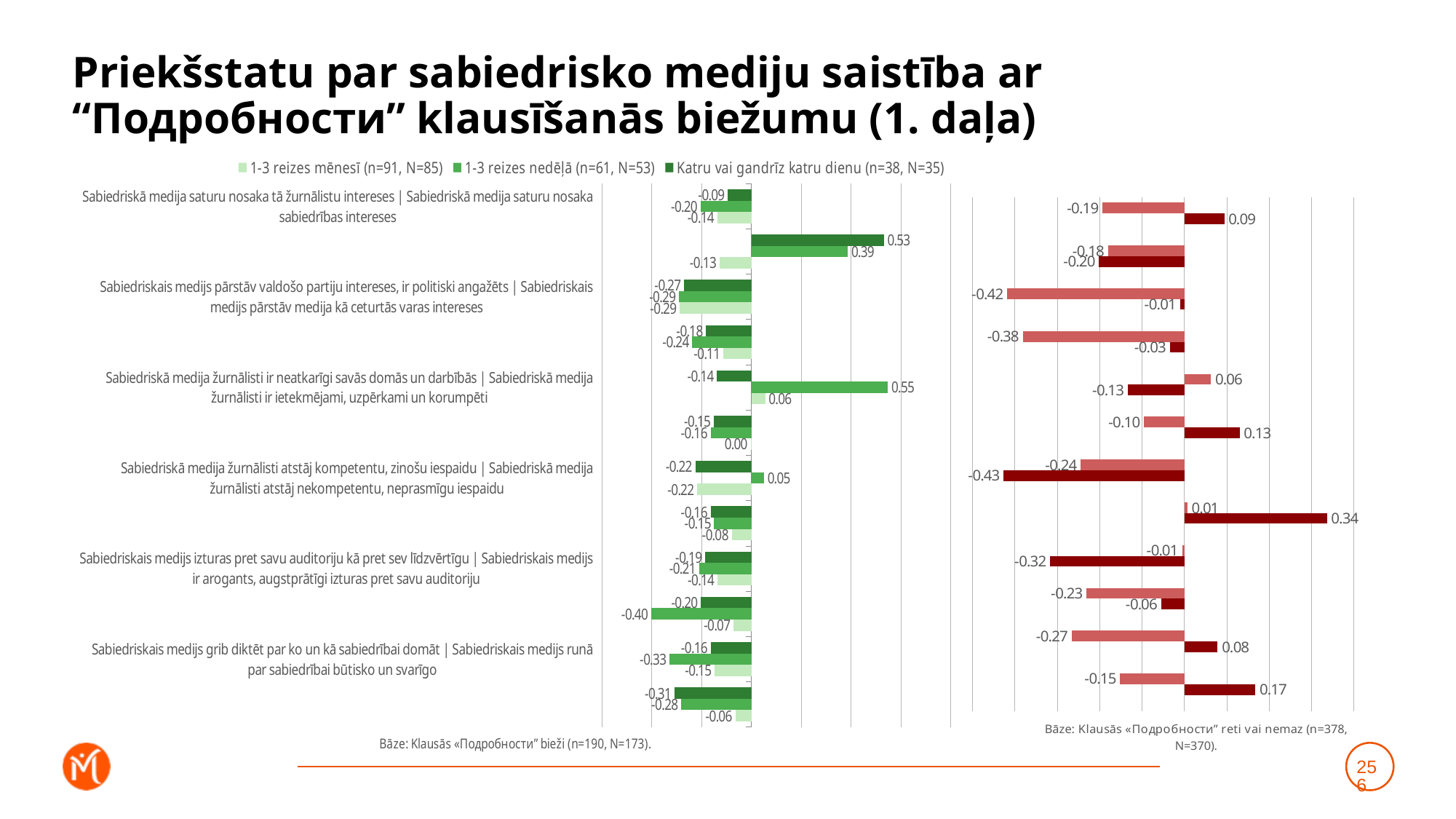
In the left (green) chart, what is the lowest value shown by any bar? -0.40 In the left (green) chart, in the group where the dark green bar is 0.53, what is the value of the medium green bar? 0.39 How many differently coloured series are plotted in the right (red) chart? 2 In the right (red) chart, what is the highest value shown by any bar? 0.34 What kind of chart is the left (green) chart on the slide? bar chart What base note is printed below the left (green) chart? Bāze: Klausās «Подробности» bieži (n=190, N=173). How many series does the legend above the left (green) chart list? 3 In the right (red) chart, what is the lowest value shown by any bar? -0.43 In the right (red) chart, which is larger: the dark red bar labelled 0.34 or the dark red bar labelled 0.17? 0.34 In the left (green) chart, what is the difference between the dark green bar of 0.53 and the medium green bar of 0.39 in the same group? 0.14 In the left (green) chart, what is the highest value shown by any bar? 0.55 In the left (green) chart, which legend entry is shown in the darkest green? Katru vai gandrīz katru dienu (n=38, N=35)